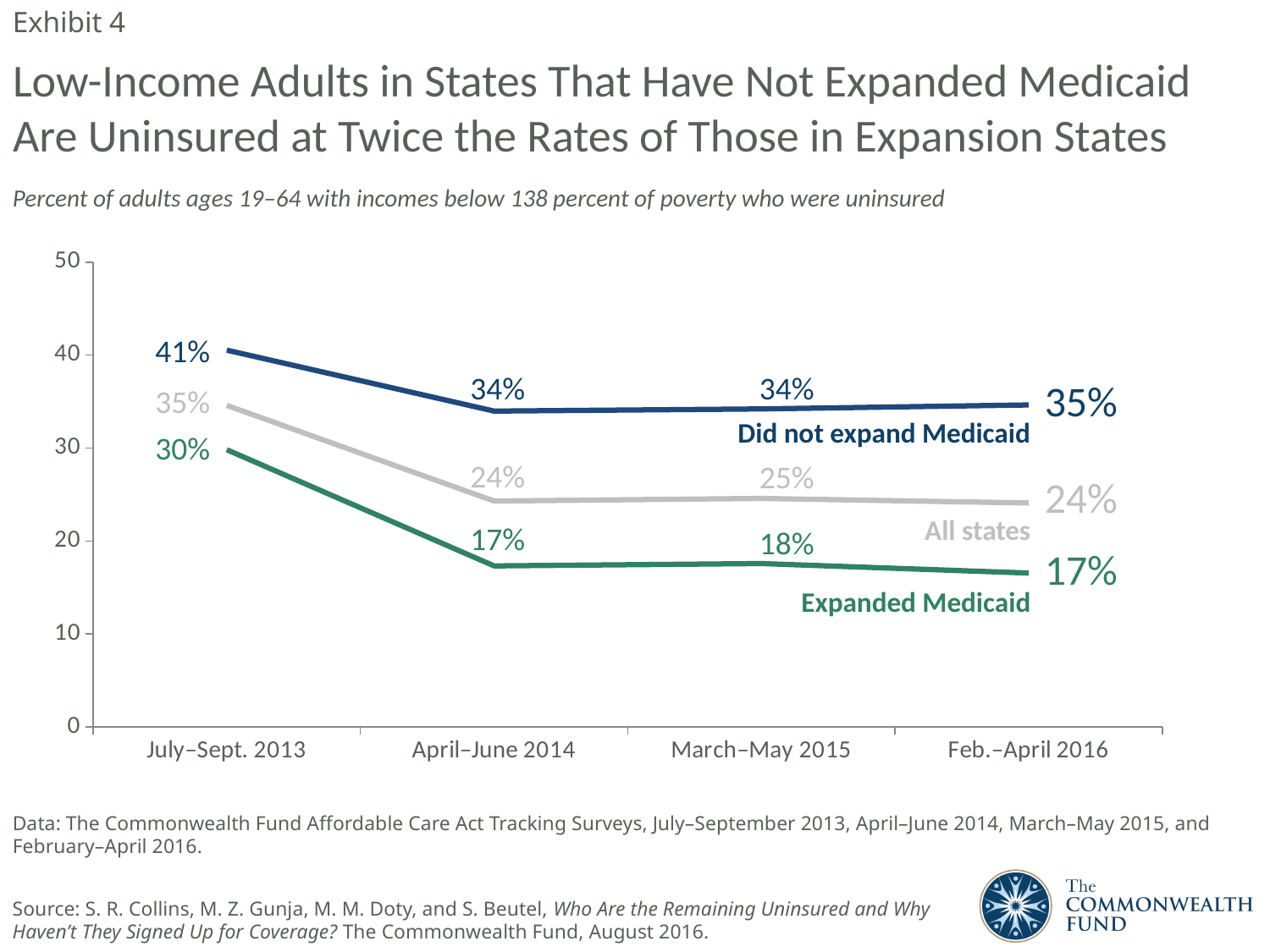
What was the uninsured rate for adults in states that expanded Medicaid in Feb.–April 2016? 17% Which series had the highest uninsured rate in April–June 2014? Did not expand Medicaid What type of chart is shown on the slide? Line chart Which series had the lowest uninsured rate in July–Sept. 2013? Expanded Medicaid What was the uninsured rate for adults in states that did not expand Medicaid in July–Sept. 2013? 41% Did the uninsured rate for states that did not expand Medicaid rise or fall from July–Sept. 2013 to April–June 2014? Fall By how many percentage points did the uninsured rate for states that expanded Medicaid fall from July–Sept. 2013 to April–June 2014? 13 percentage points Which was larger in March–May 2015: the uninsured rate for all states or for states that expanded Medicaid? All states How many series are plotted on the chart? 3 How many time periods are shown on the x axis? 4 What was the uninsured rate for all states in March–May 2015? 25% What is the difference between the uninsured rates for states that did not expand Medicaid and states that expanded Medicaid in Feb.–April 2016? 18 percentage points